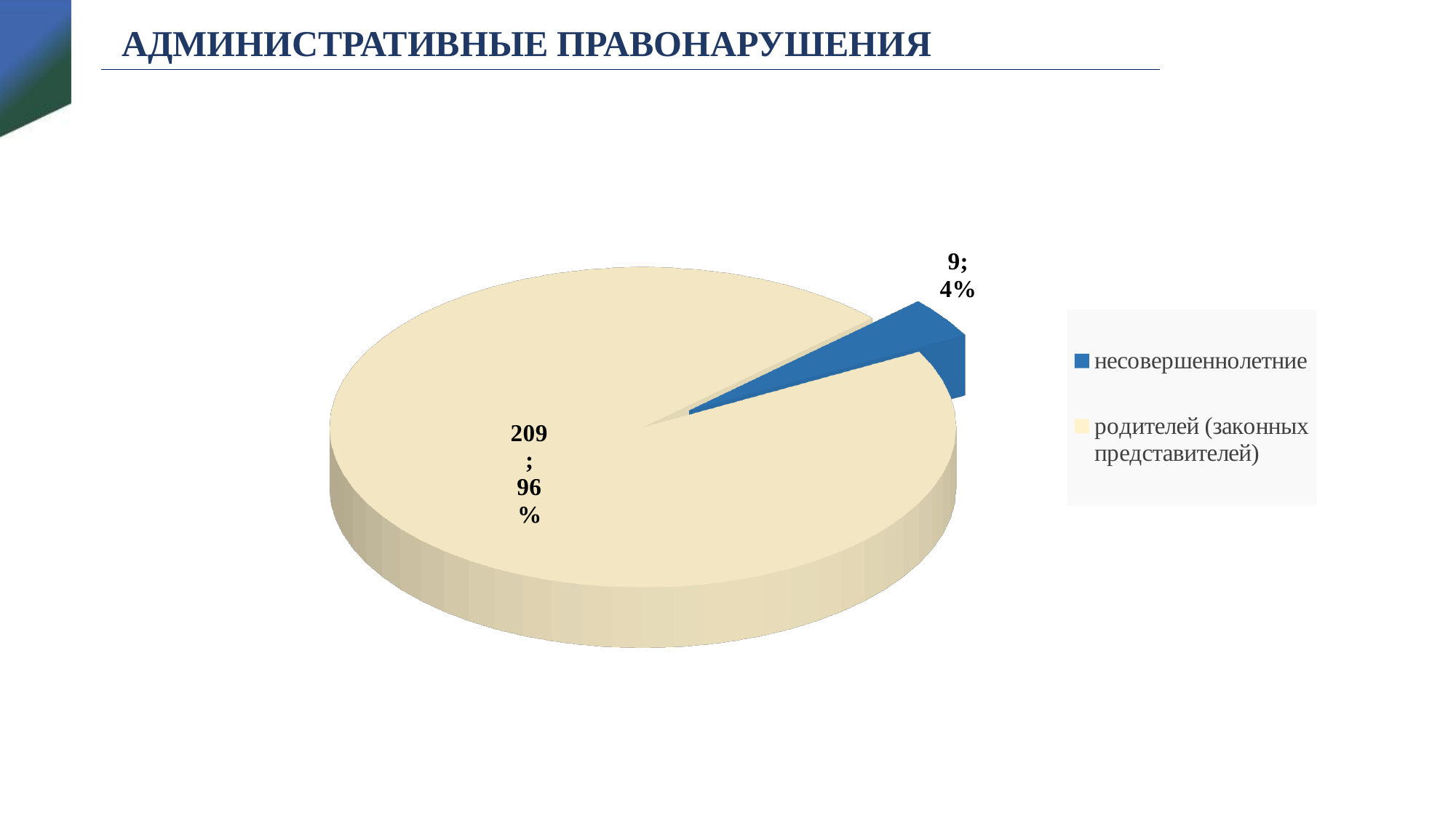
What colour is the несовершеннолетние slice? blue What is the total of the two values shown in the pie chart? 218 Which is larger, the value for несовершеннолетние or the value for родителей (законных представителей)? родителей (законных представителей) Which category has the largest slice? родителей (законных представителей) What is the difference between the values for родителей (законных представителей) and несовершеннолетние? 200 How many slices does the pie chart have? 2 What share of the pie does the несовершеннолетние slice represent? 4% What is the value for несовершеннолетние? 9 What is the value for родителей (законных представителей)? 209 What kind of chart is shown on the slide? pie chart Which category has the smallest slice? несовершеннолетние What share of the pie does the родителей (законных представителей) slice represent? 96%